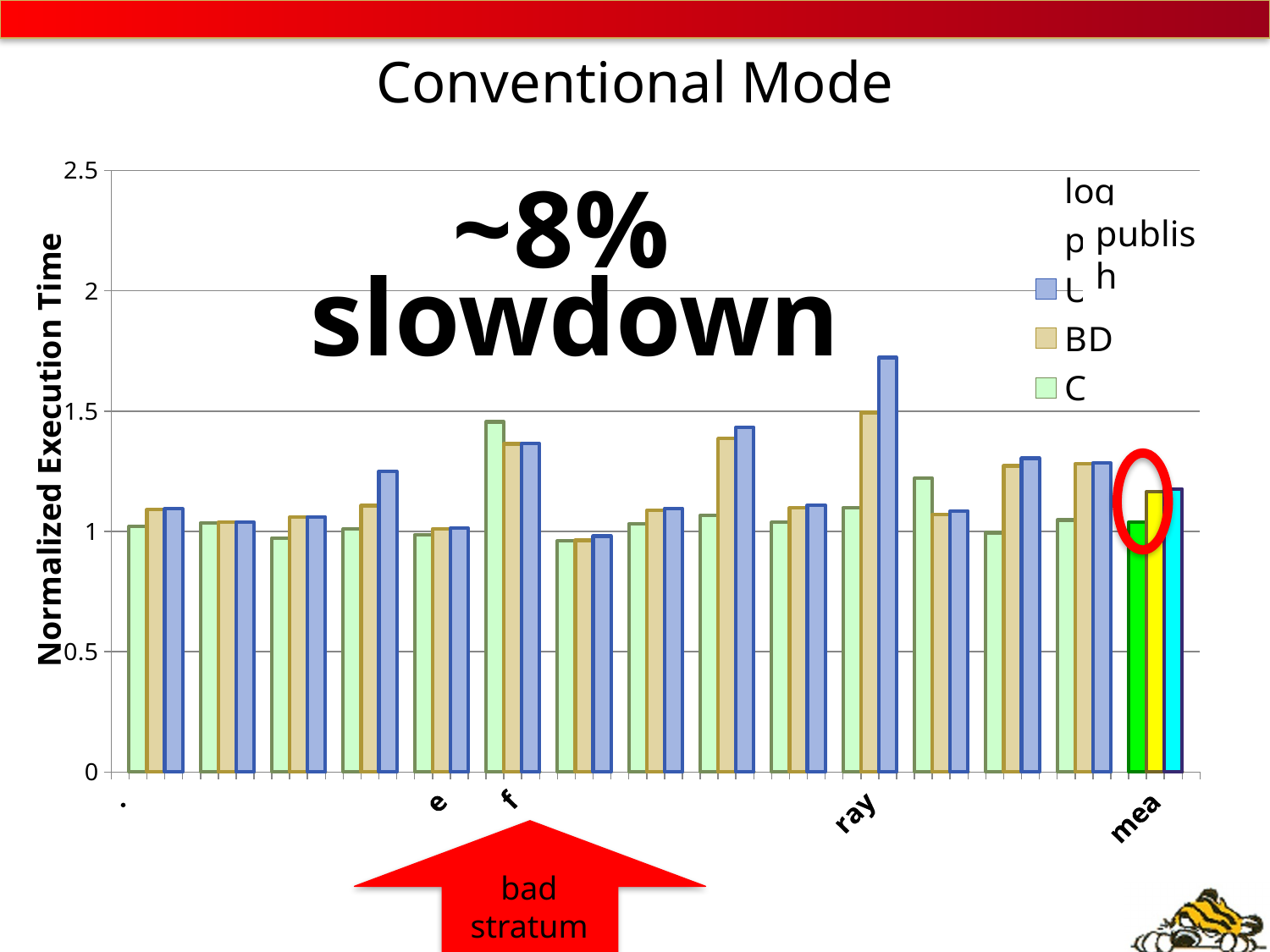
How many series does the legend list? 5 Are the bars for the category 'mea' greater or less than 1.5? less What is the title of the chart? Conventional Mode Are the bars for the category 'e' greater or less than 1.5? less What is the label of the vertical axis? Normalized Execution Time What kind of chart is shown on the slide? bar chart What is the highest value shown on the vertical axis? 2.5 Is the tallest bar for the category 'ray' greater or less than 1.5? greater How many groups of bars (categories) are plotted along the x axis? 15 Which labelled category contains the tallest bar in the chart? ray